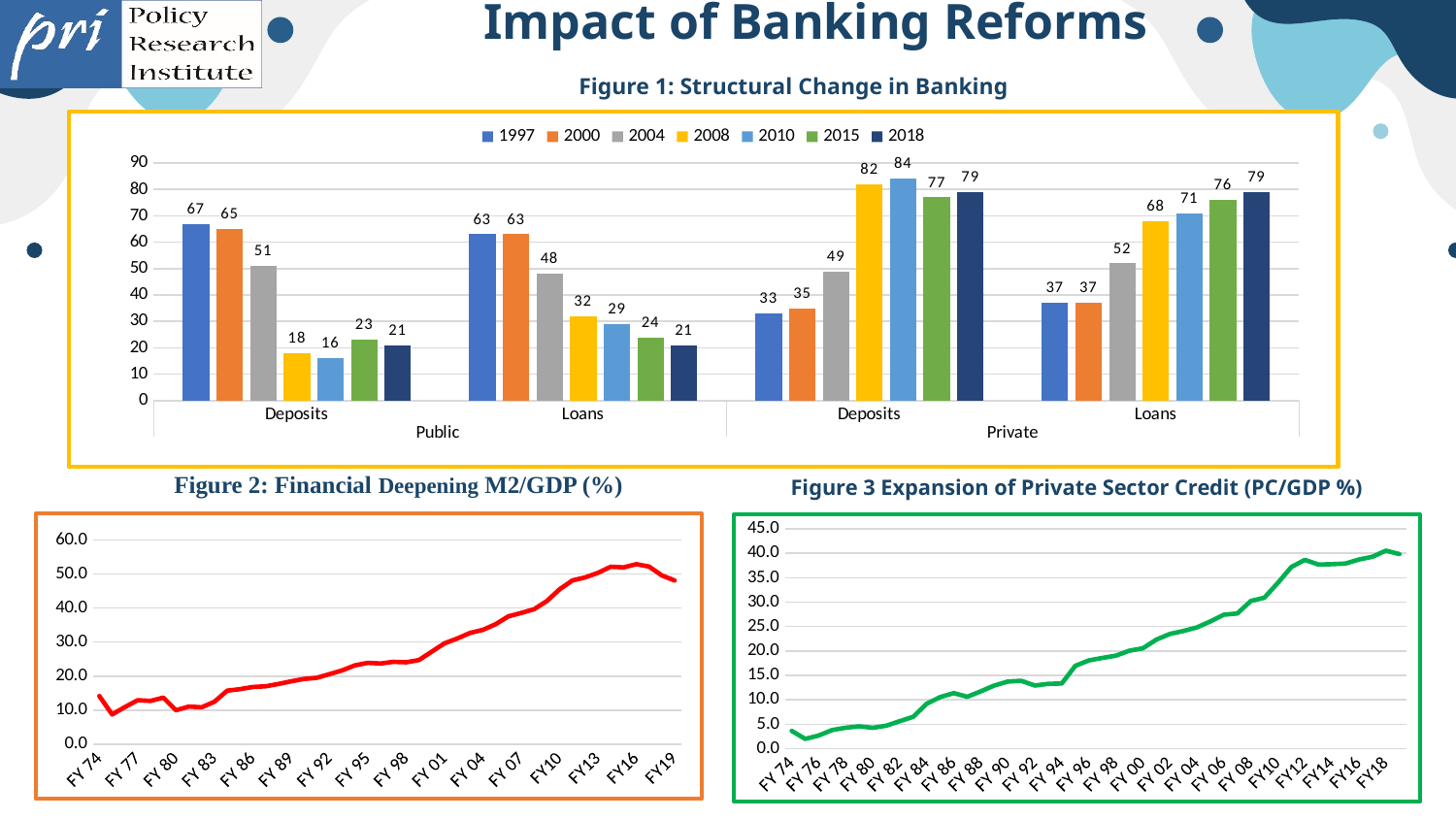
In Figure 1: Structural Change in Banking, which is larger in 2008: Public Loans or Private Loans? Private Loans In Figure 1: Structural Change in Banking, which year has the lowest value for Public Deposits? 2010 In Figure 3 Expansion of Private Sector Credit (PC/GDP %), do the values generally rise or fall from FY74 to FY18? rise In Figure 1: Structural Change in Banking, what is the difference between the Private Deposits values for 2010 and 1997? 51 How many category groups (Deposits/Loans bars) are shown along the x axis of Figure 1: Structural Change in Banking? 4 How many series does the legend of Figure 1: Structural Change in Banking list? 7 What kind of chart is Figure 2: Financial Deepening M2/GDP (%)? line chart In Figure 1: Structural Change in Banking, what is the value for Public Deposits in 1997? 67 In Figure 3 Expansion of Private Sector Credit (PC/GDP %), is the value for FY18 greater or less than 35.0? greater In Figure 1: Structural Change in Banking, what is the value for Private Deposits in 2010? 84 In Figure 1: Structural Change in Banking, which year has the highest value for Private Loans? 2018 In Figure 1: Structural Change in Banking, what colour represents the 2008 series? yellow